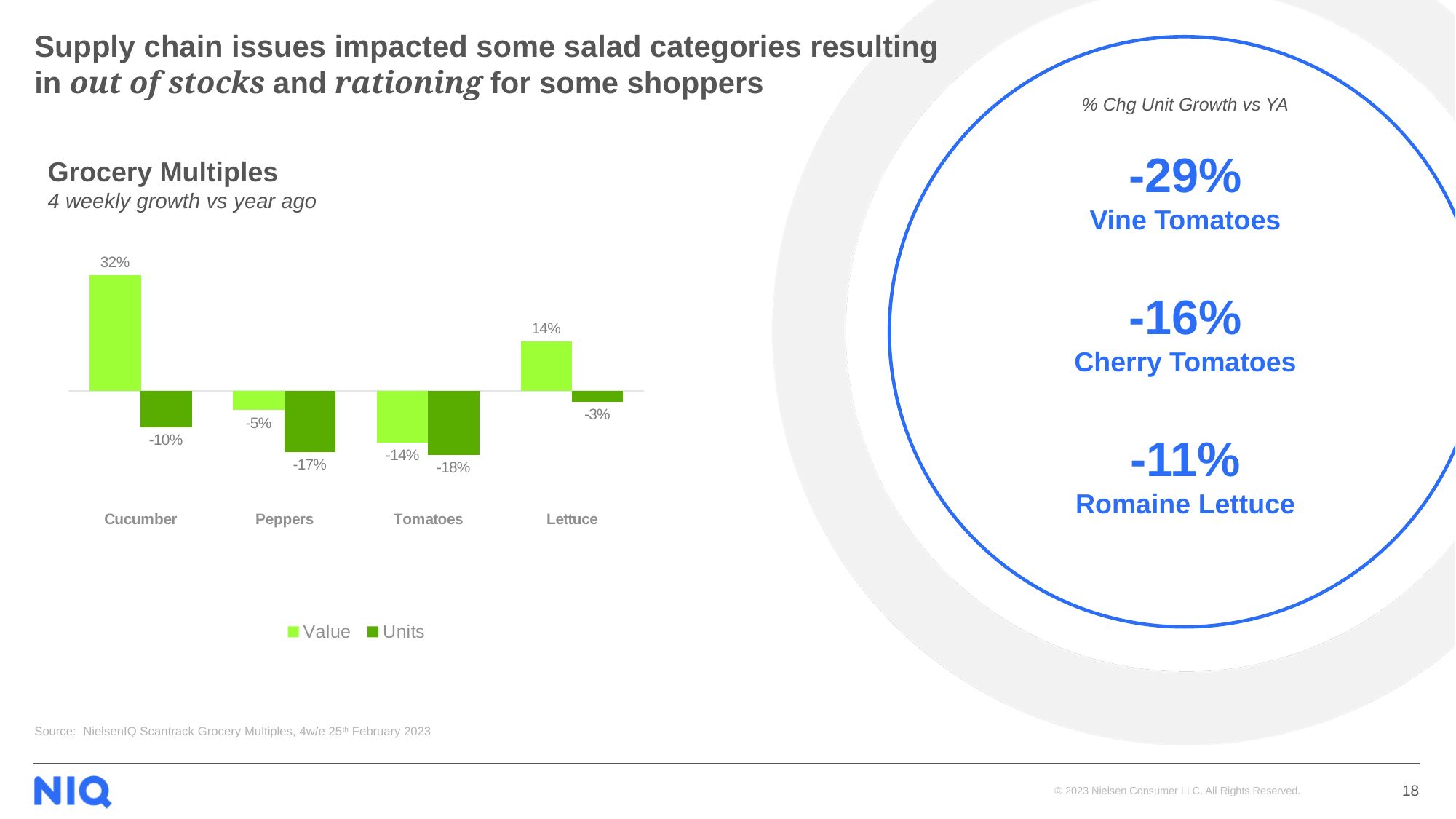
What is the Value growth for Cucumber? 32% How many series does the chart legend list? 2 What is the difference between the Value and Units growth for Cucumber? 42 percentage points Which is larger, the Units growth for Cucumber or the Units growth for Peppers? Cucumber Which category has the highest Value growth? Cucumber What kind of chart is shown on the slide? Bar chart What are the two series named in the chart legend? Value and Units How many categories are shown on the x axis of the chart? 4 Which category has the lowest Units growth? Tomatoes What is the Value growth for Tomatoes? -14% What is the Units growth for Lettuce? -3% What is the Units growth for Peppers? -17%